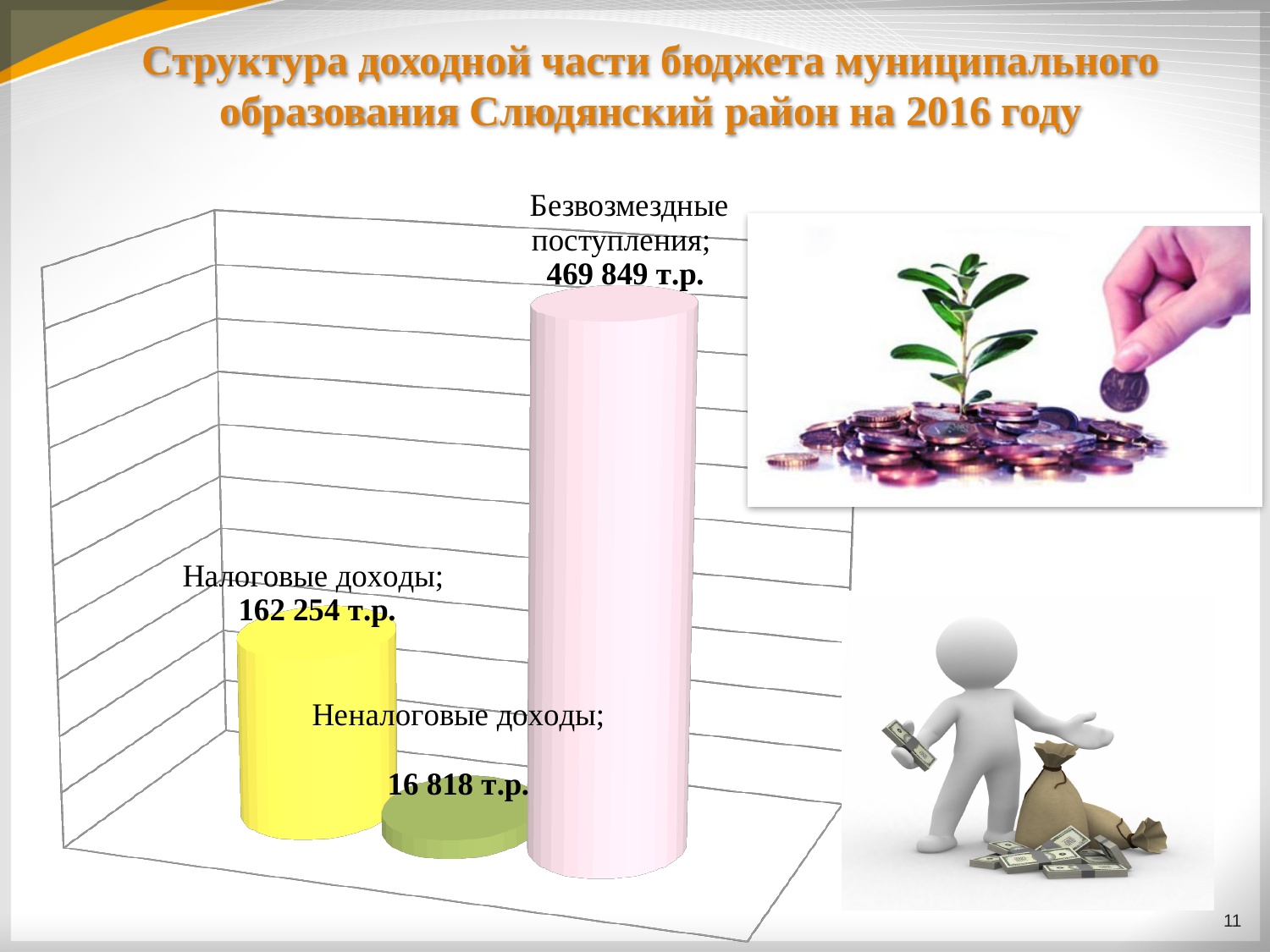
What is the value shown for Безвозмездные поступления? 469 849 т.р. What colour is the bar for Налоговые доходы? Yellow What kind of chart is shown on the slide? Bar chart What is the difference between Налоговые доходы and Неналоговые доходы? 145 436 т.р. Which category has the highest value? Безвозмездные поступления What is the value shown for Налоговые доходы? 162 254 т.р. Which is larger, Налоговые доходы or Неналоговые доходы? Налоговые доходы Which is larger, Безвозмездные поступления or Налоговые доходы? Безвозмездные поступления How many categories are plotted in the chart? 3 What is the difference between Безвозмездные поступления and Налоговые доходы? 307 595 т.р. What is the value shown for Неналоговые доходы? 16 818 т.р. Which category has the lowest value? Неналоговые доходы